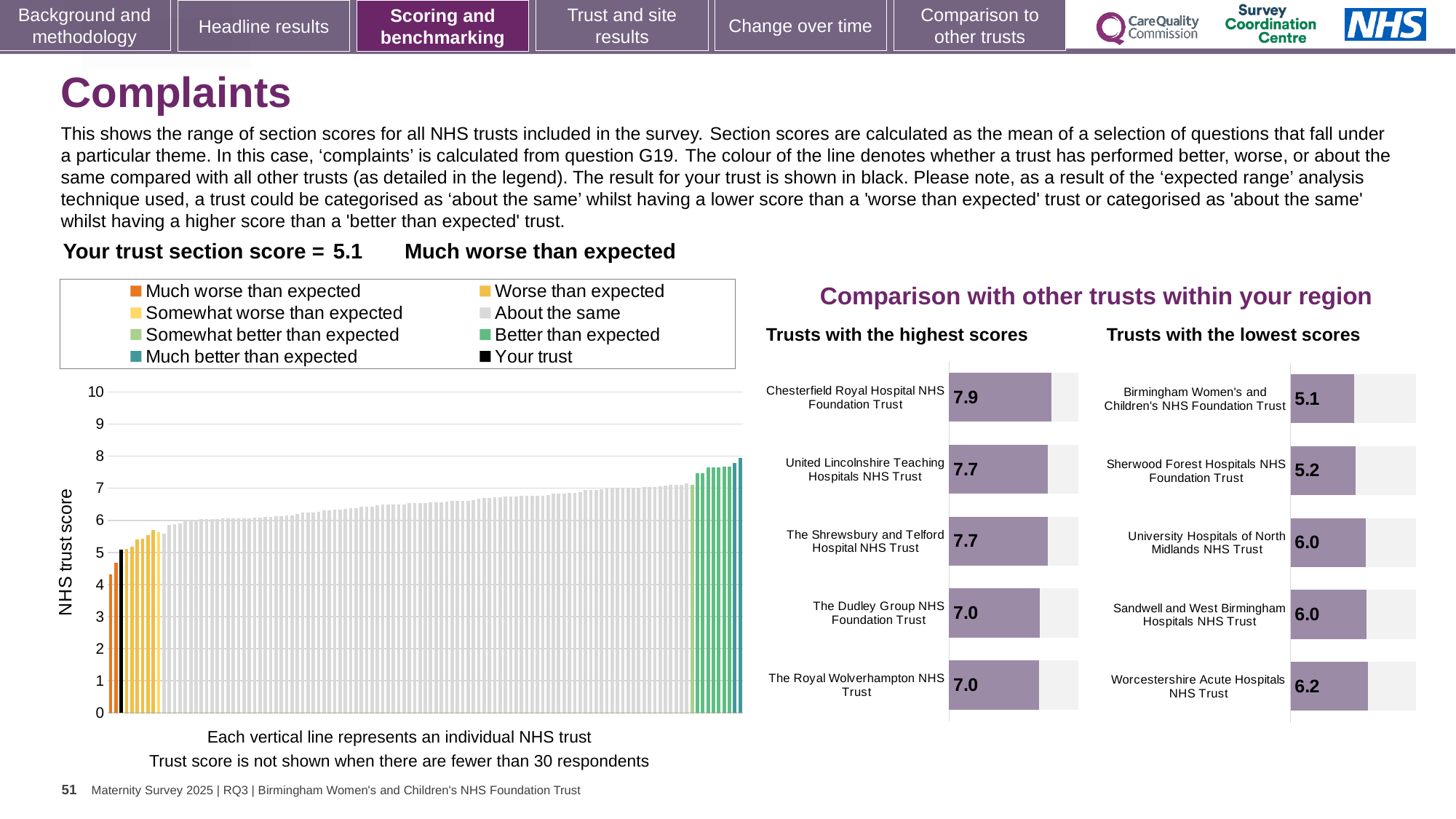
In the 'Trusts with the highest scores' chart, how many trusts are listed? 5 What kind of chart is the main NHS trust score chart? bar chart In the 'Trusts with the highest scores' chart, which trust has the highest score? Chesterfield Royal Hospital NHS Foundation Trust In the 'Trusts with the highest scores' chart, what is the score for Chesterfield Royal Hospital NHS Foundation Trust? 7.9 In the 'Trusts with the lowest scores' chart, which trust has the lowest score? Birmingham Women's and Children's NHS Foundation Trust In the main NHS trust score chart, do the bar values rise or fall from left to right? rise In the 'Trusts with the highest scores' chart, what is the difference between the scores of Chesterfield Royal Hospital NHS Foundation Trust and The Dudley Group NHS Foundation Trust? 0.9 In the 'Trusts with the lowest scores' chart, which has the higher score: Sherwood Forest Hospitals NHS Foundation Trust or University Hospitals of North Midlands NHS Trust? University Hospitals of North Midlands NHS Trust How many entries does the legend above the main NHS trust score chart list? 8 In the 'Trusts with the lowest scores' chart, what is the difference between the scores of Worcestershire Acute Hospitals NHS Trust and Birmingham Women's and Children's NHS Foundation Trust? 1.1 In the 'Trusts with the lowest scores' chart, what is the score for Sherwood Forest Hospitals NHS Foundation Trust? 5.2 In the main NHS trust score chart, is the value for the black 'Your trust' bar greater or less than 6? less